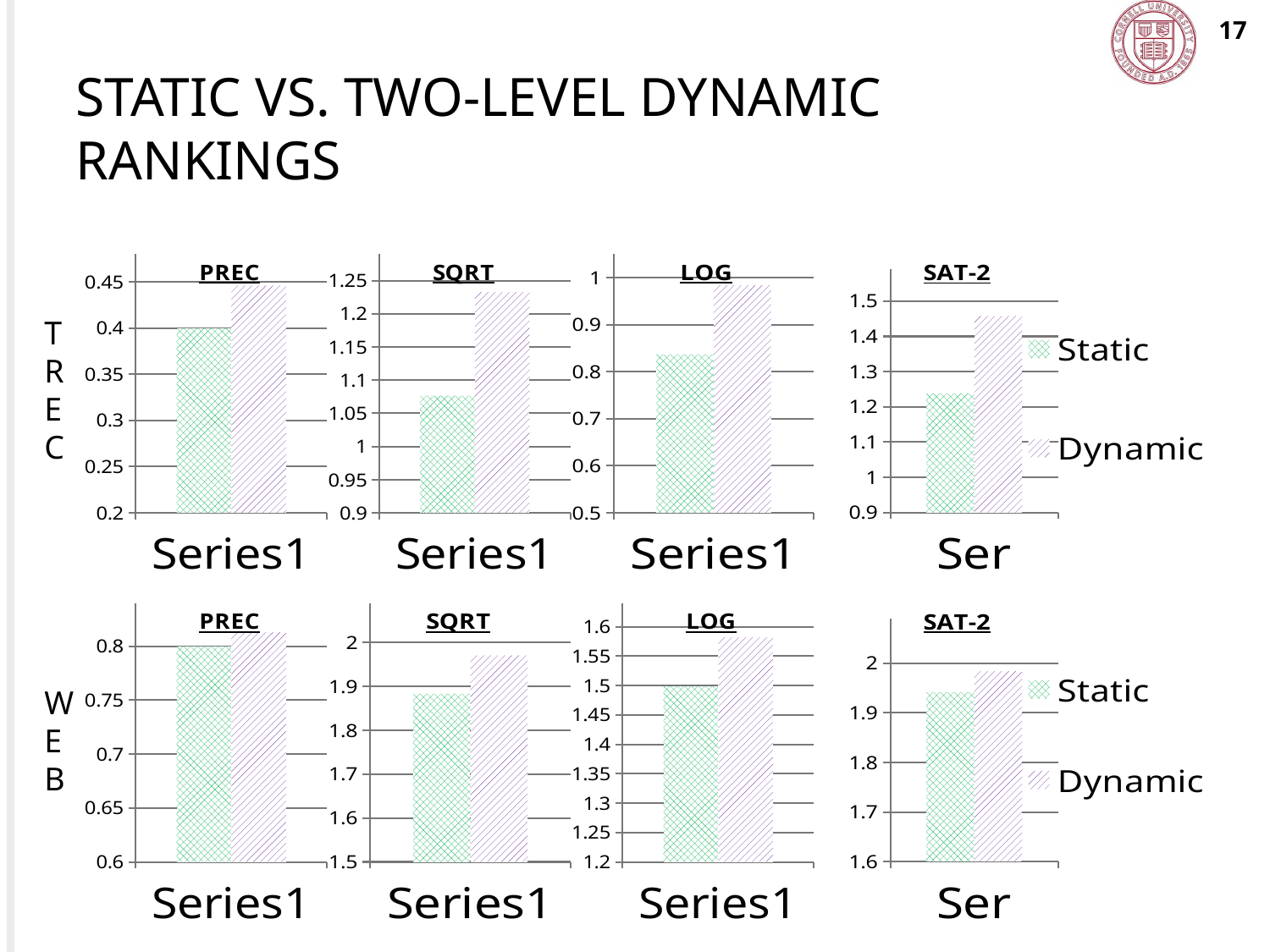
In the TREC SQRT chart (top row, second from left), is the value for Static greater or less than 1.1? less In the WEB LOG chart (bottom row, third from left), is the value for Dynamic greater or less than 1.55? greater In the WEB SQRT chart (bottom row, second from left), is the value for Static greater or less than 1.9? less What are the two legend entries shown next to the SAT-2 charts? Static and Dynamic In the WEB LOG chart (bottom row, third from left), which is larger, the Static bar or the Dynamic bar? Dynamic In the TREC PREC chart (top left), which is larger, the Static bar or the Dynamic bar? Dynamic How many series does the legend list for the SAT-2 charts? 2 What kind of chart is the WEB PREC chart (bottom left)? bar chart